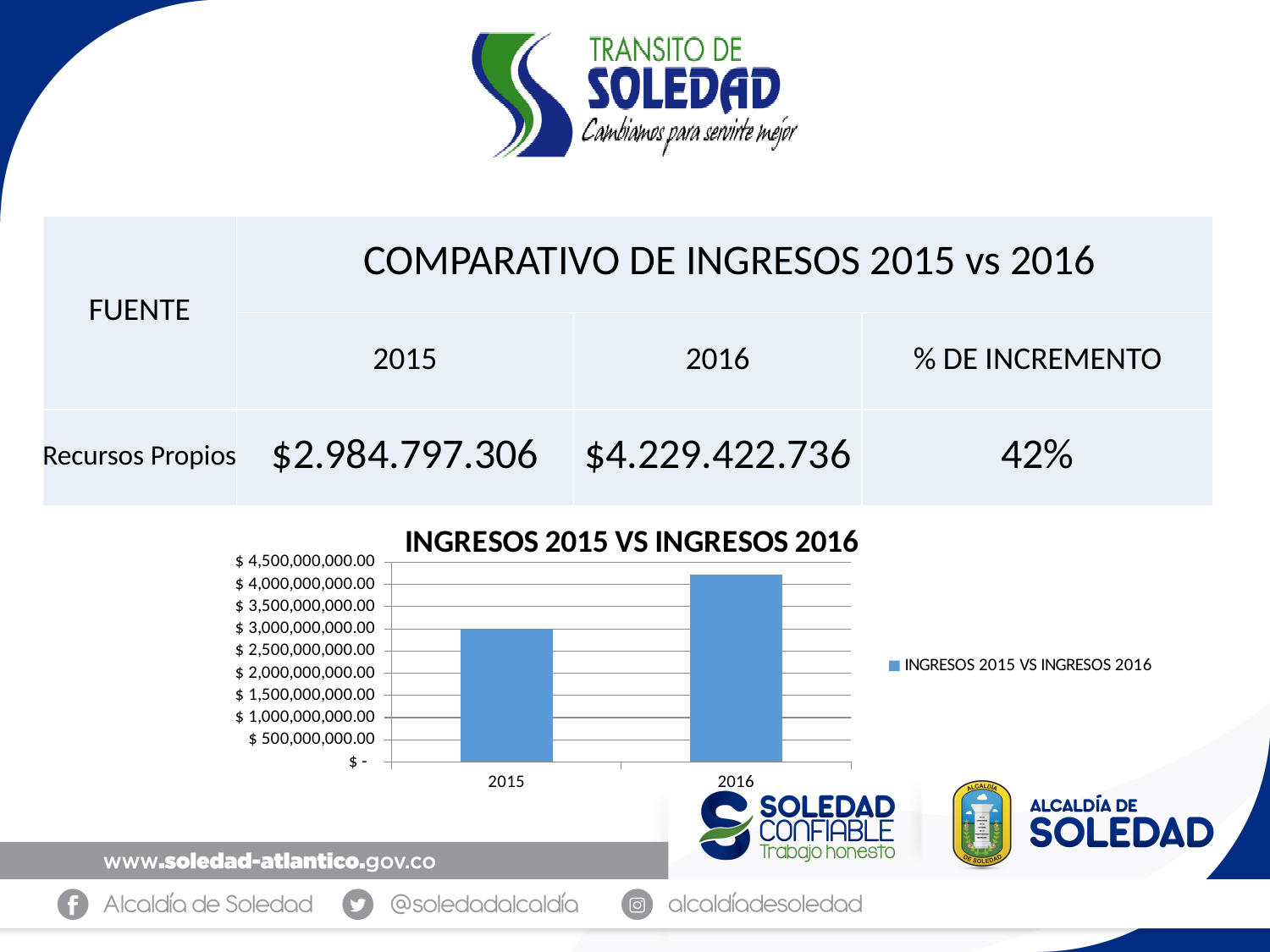
Is the value for 2015 greater or less than $ 2,500,000,000.00? greater How many series does the chart legend list? 1 Is the value for 2016 greater or less than $ 4,000,000,000.00? greater Do the values rise or fall from 2015 to 2016? rise What is the title of the chart? INGRESOS 2015 VS INGRESOS 2016 Is the bar for 2016 larger or smaller than the bar for 2015? larger What type of chart is shown on the slide? bar chart Which year has the lowest bar in the chart? 2015 According to the table, what is the % de incremento from 2015 to 2016? 42% How many categories are shown on the x axis of the chart? 2 According to the table, what were the Recursos Propios ingresos in 2016? $4.229.422.736 Which year has the highest bar in the chart? 2016